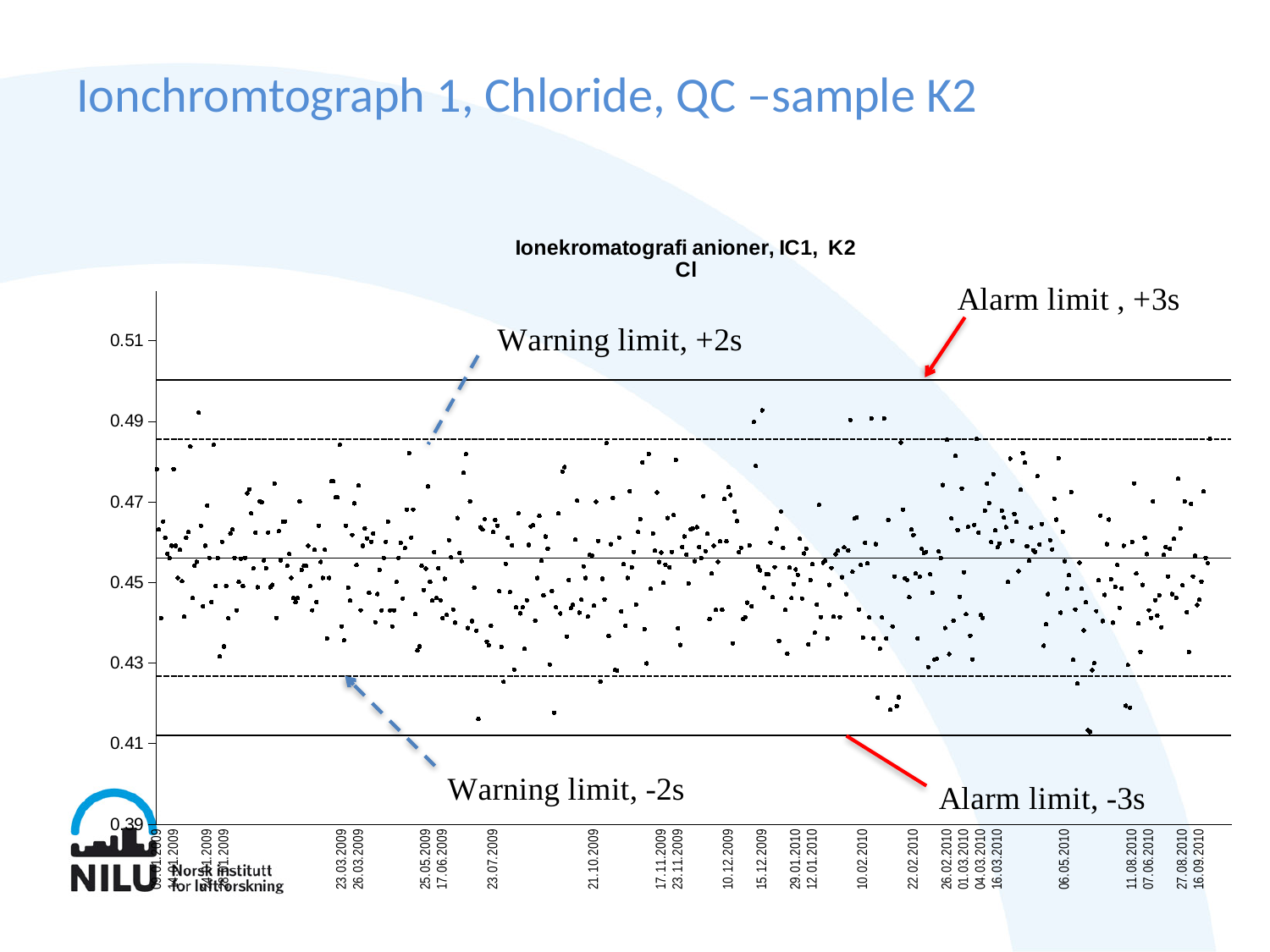
What is the title printed above the chart? Ionekromatografi anioner, IC1, K2 Cl Is the upper warning limit (+2s) line greater or less than 0.49 on the y axis? less What label is given to the uppermost solid horizontal line on the chart? Alarm limit, +3s Is the central mean line of the chart greater or less than 0.45 on the y axis? greater What kind of chart is shown on the slide? scatter chart Which is higher on the y axis, the upper warning limit (+2s) line or the upper alarm limit (+3s) line? Alarm limit, +3s Is the lower warning limit (-2s) line greater or less than 0.41 on the y axis? greater Which is lower on the y axis, the lower warning limit (-2s) line or the lower alarm limit (-3s) line? Alarm limit, -3s